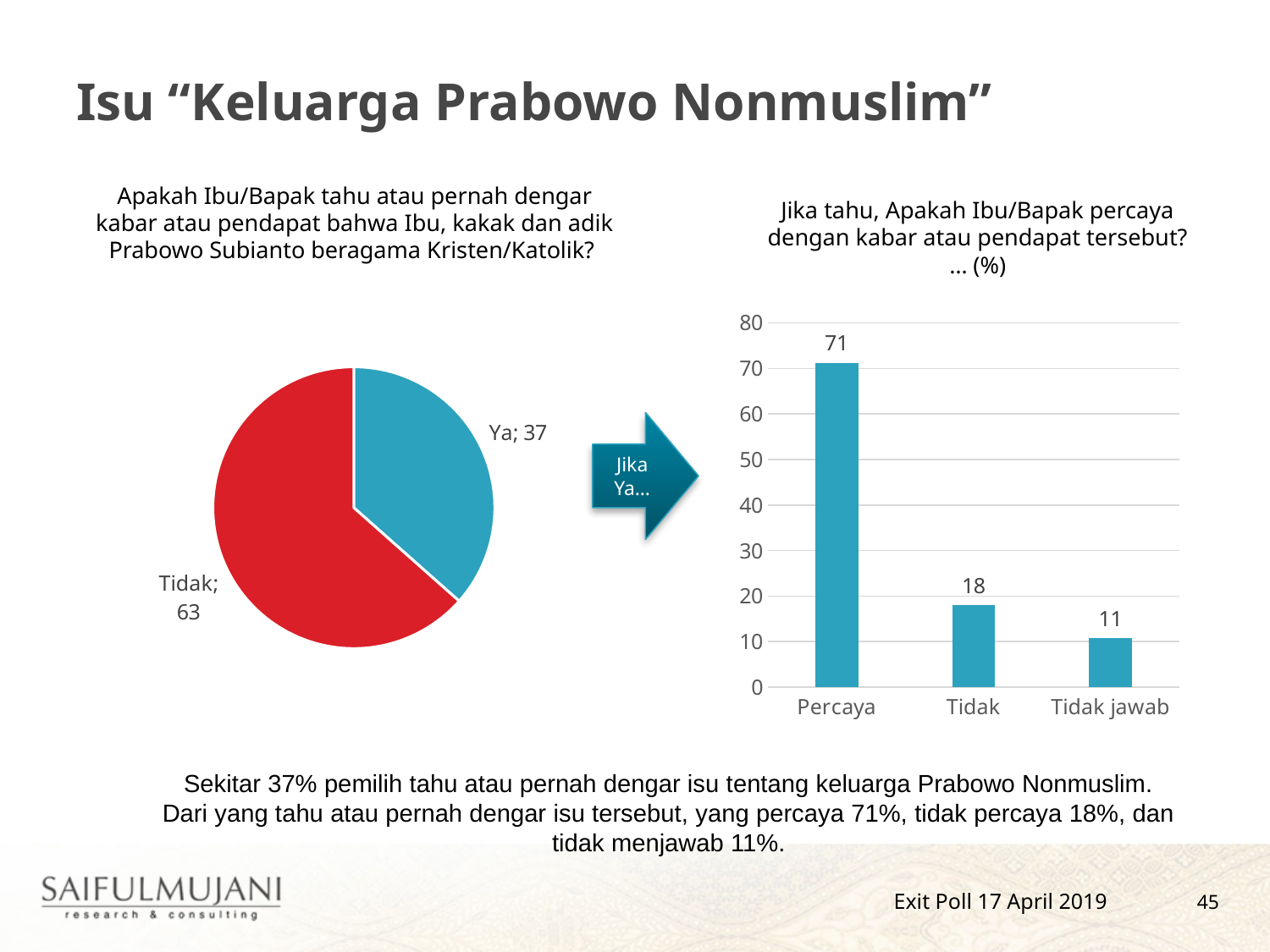
In the bar chart on the right, what is the value for "Percaya"? 71 In the pie chart on the left, what is the value for "Ya"? 37 In the bar chart on the right, what is the difference between "Percaya" and "Tidak"? 53 In the pie chart on the left, what is the value for "Tidak"? 63 In the bar chart on the right, what is the value for "Tidak jawab"? 11 What kind of chart is the chart on the left? pie chart In the bar chart on the right, how many categories are shown on the x axis? 3 In the pie chart on the left, which slice is larger, "Ya" or "Tidak"? Tidak In the bar chart on the right, which category has the lowest value? Tidak jawab In the pie chart on the left, what is the difference between the "Tidak" and "Ya" values? 26 In the pie chart on the left, how many slices are there? 2 In the bar chart on the right, do the values rise or fall from left to right along the x axis? fall